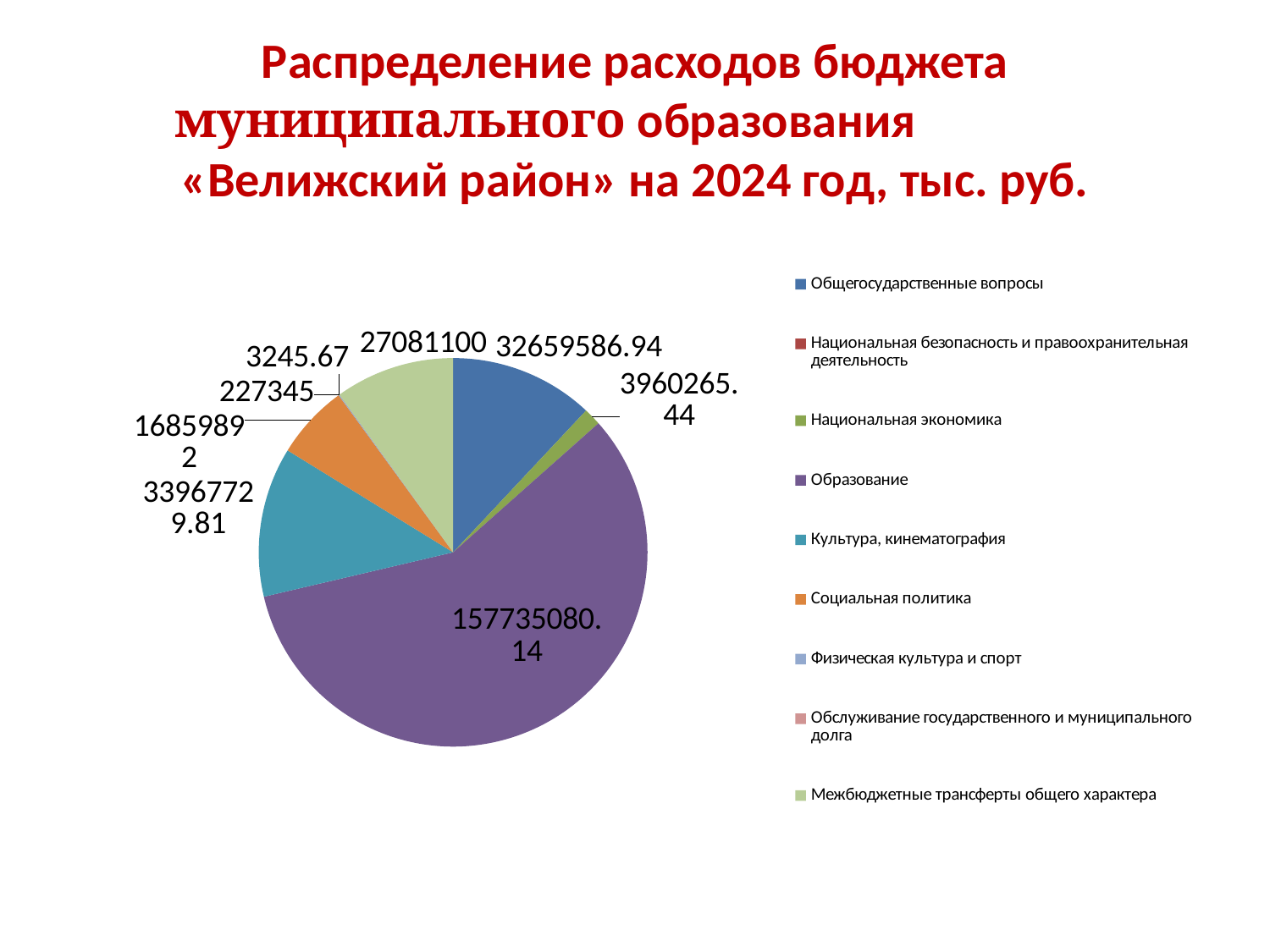
How many categories does the legend list? 9 Which is larger, Образование or Культура, кинематография? Образование What is the value for Национальная экономика? 3960265.44 What is the value for Образование? 157735080.14 What is the value for Социальная политика? 16859892 Which category has the largest slice of the pie? Образование What is the value for Культура, кинематография? 33967729.81 What is the value for Общегосударственные вопросы? 32659586.94 What colour is the slice for Образование? purple What kind of chart is shown on the slide? pie chart What is the difference between Культура, кинематография and Общегосударственные вопросы? 1308142.87 What is the value for Межбюджетные трансферты общего характера? 27081100